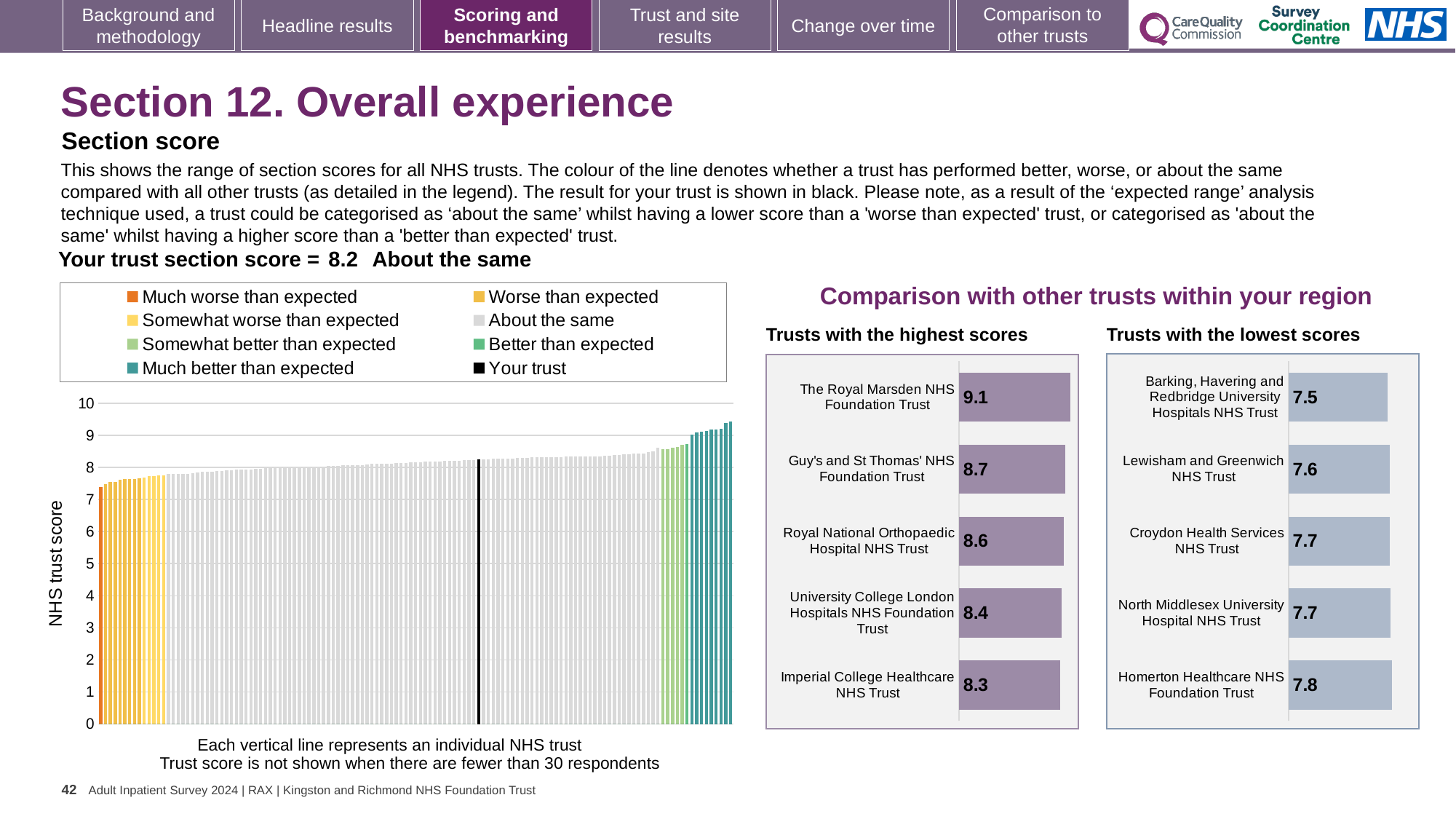
In the 'Trusts with the highest scores' chart, which has a higher score: Royal National Orthopaedic Hospital NHS Trust or University College London Hospitals NHS Foundation Trust? Royal National Orthopaedic Hospital NHS Trust In the main NHS trust score chart on the left, do the values rise or fall from left to right? rise In the 'Trusts with the highest scores' chart, what is the score for Imperial College Healthcare NHS Trust? 8.3 In the 'Trusts with the highest scores' chart, what is the difference between the scores of The Royal Marsden NHS Foundation Trust and Guy's and St Thomas' NHS Foundation Trust? 0.4 In the main NHS trust score chart on the left, is the value of the leftmost bar greater or less than 8? less How many trusts are shown in the 'Trusts with the lowest scores' chart? 5 How many entries does the legend of the main NHS trust score chart list? 8 In the 'Trusts with the lowest scores' chart, which trust has the lowest score? Barking, Havering and Redbridge University Hospitals NHS Trust In the 'Trusts with the lowest scores' chart, what is the difference between the scores of Homerton Healthcare NHS Foundation Trust and Barking, Havering and Redbridge University Hospitals NHS Trust? 0.3 In the 'Trusts with the highest scores' chart, which trust has the highest score? The Royal Marsden NHS Foundation Trust In the 'Trusts with the highest scores' chart, what is the score for The Royal Marsden NHS Foundation Trust? 9.1 In the 'Trusts with the lowest scores' chart, what is the score for Lewisham and Greenwich NHS Trust? 7.6